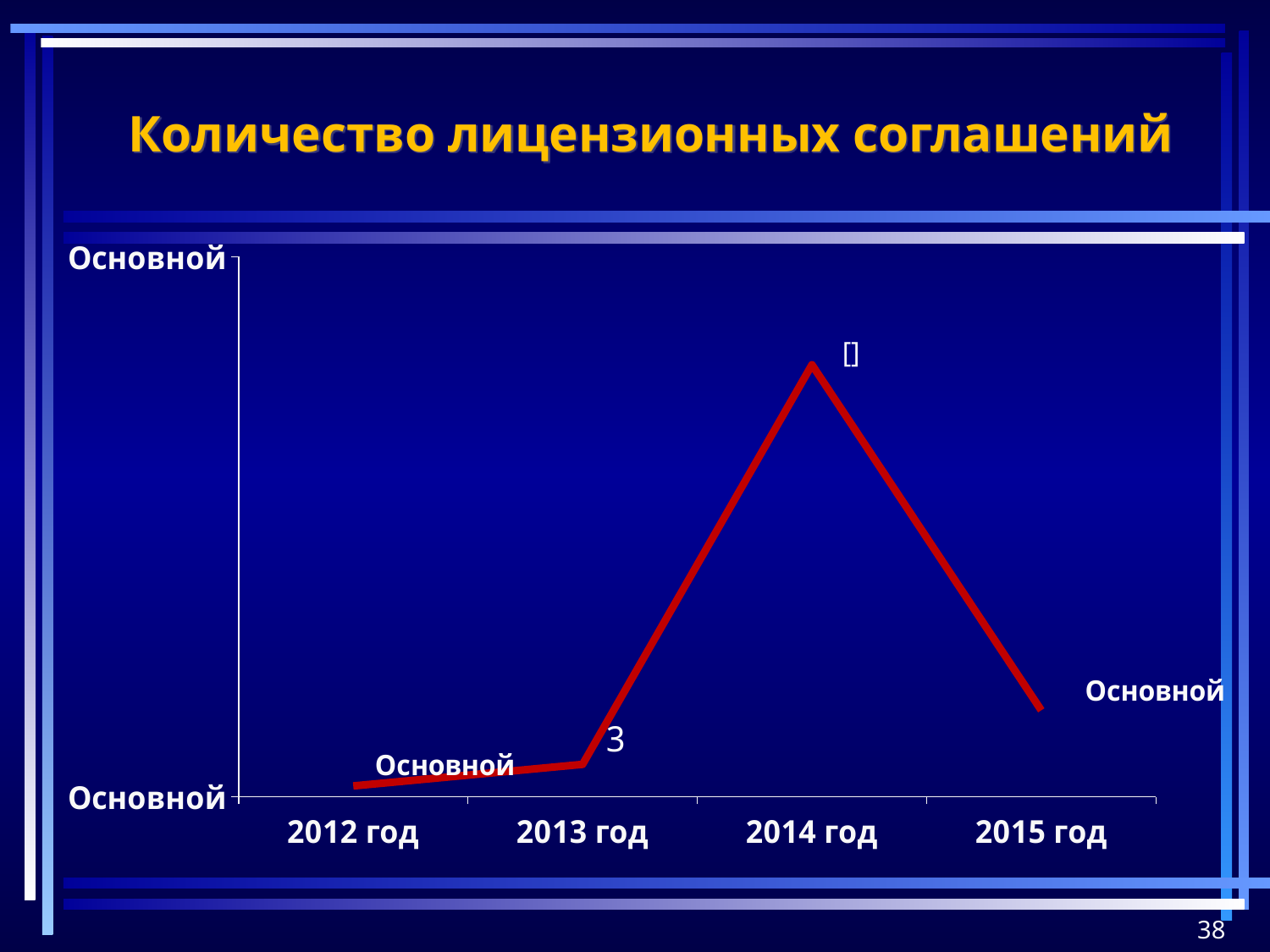
Which year has the highest value on the chart? 2014 год What colour is the line on the chart? red What kind of chart is shown on the slide? line chart How many lines (data series) are plotted on the chart? 1 Which is larger, the value for 2013 год or the value for 2015 год? 2015 год Does the line rise or fall from 2012 год to 2014 год? rise What is the title of the chart? Количество лицензионных соглашений What is the value plotted for 2013 год? 3 Which is larger, the value for 2014 год or the value for 2015 год? 2014 год Does the line rise or fall from 2014 год to 2015 год? fall Which year has the lowest value on the chart? 2012 год How many years are shown on the x axis of the chart? 4